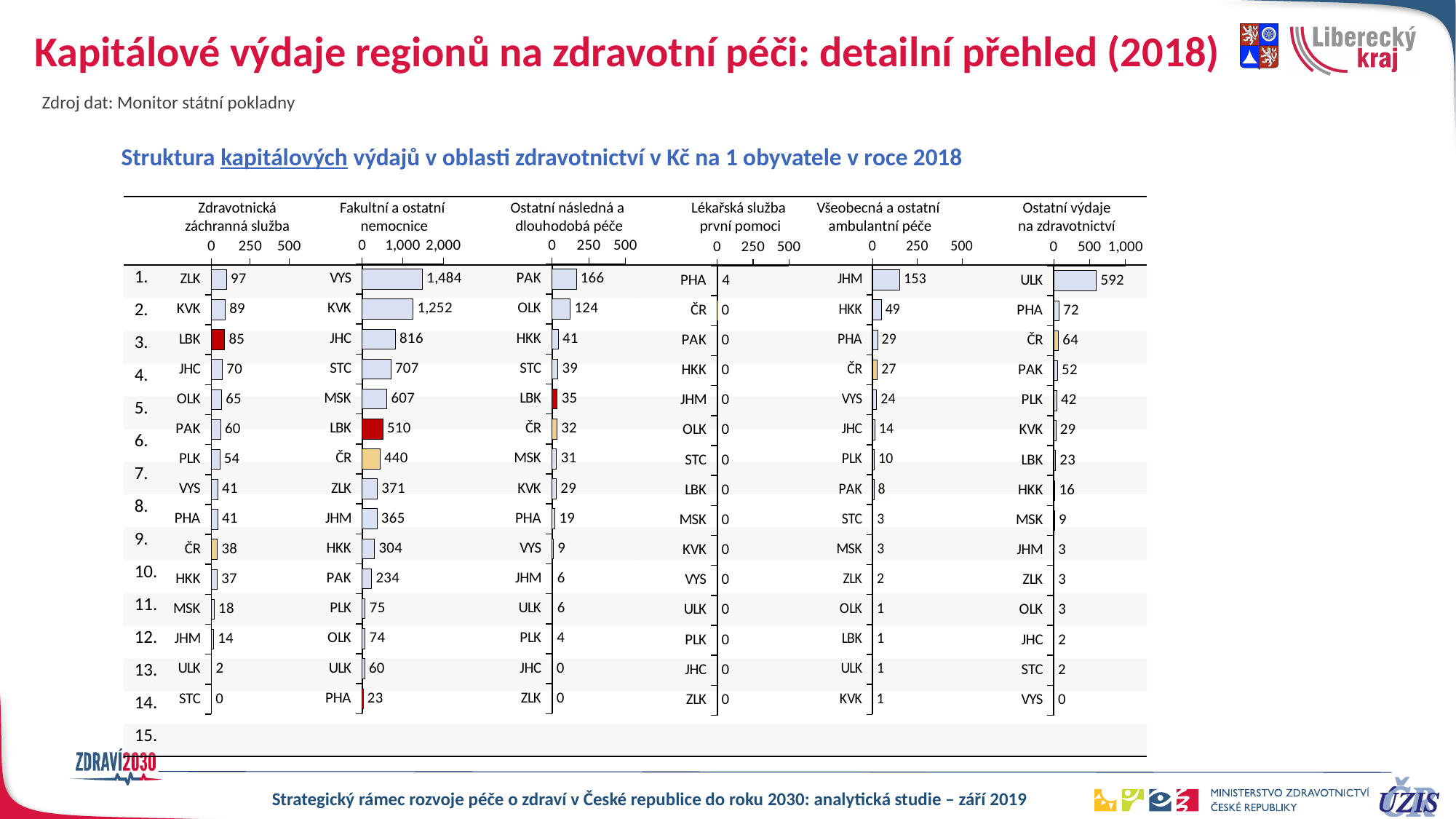
In the 'Všeobecná a ostatní ambulantní péče' chart, what is the value for ČR? 27 In the 'Lékařská služba první pomoci' chart, what is the value for PHA? 4 In the 'Zdravotnická záchranná služba' chart, what is the value for LBK? 85 In the 'Fakultní a ostatní nemocnice' chart, which region has the highest value? VYS In the 'Fakultní a ostatní nemocnice' chart, what is the value for VYS? 1,484 In the 'Všeobecná a ostatní ambulantní péče' chart, which region has the highest value? JHM In the 'Ostatní následná a dlouhodobá péče' chart, what is the value for LBK? 35 What type of chart is used for 'Ostatní výdaje na zdravotnictví'? Bar chart In the 'Fakultní a ostatní nemocnice' chart, which is larger, LBK or ČR? LBK How many categories are shown in the 'Ostatní následná a dlouhodobá péče' chart? 15 In the 'Ostatní výdaje na zdravotnictví' chart, what is the difference between ULK and PHA? 520 In the 'Zdravotnická záchranná služba' chart, what is the difference between ZLK and KVK? 8